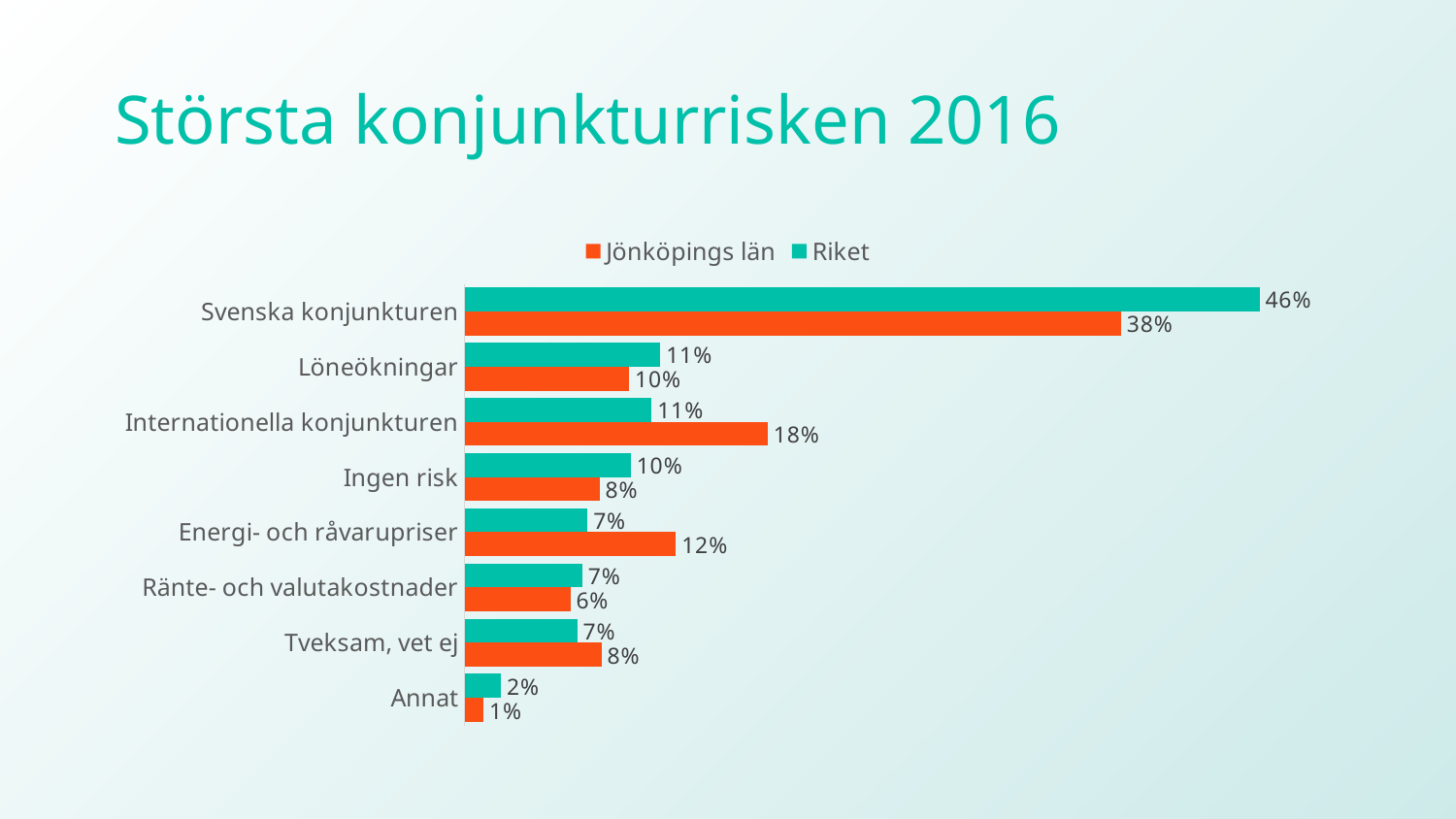
What is the Jönköpings län value for Energi- och råvarupriser? 12% What is the Jönköpings län value for Internationella konjunkturen? 18% Which category has the highest Jönköpings län value? Svenska konjunkturen Which series is shown in orange? Jönköpings län How many series does the legend list? 2 What kind of chart is shown on the slide? Bar chart For Internationella konjunkturen, which series has the larger value, Jönköpings län or Riket? Jönköpings län What is the Riket value for Svenska konjunkturen? 46% Which category has the lowest Riket value? Annat What is the title of the slide? Största konjunkturrisken 2016 What is the difference between the Riket and Jönköpings län values for Svenska konjunkturen? 8% How many categories are shown in the chart? 8